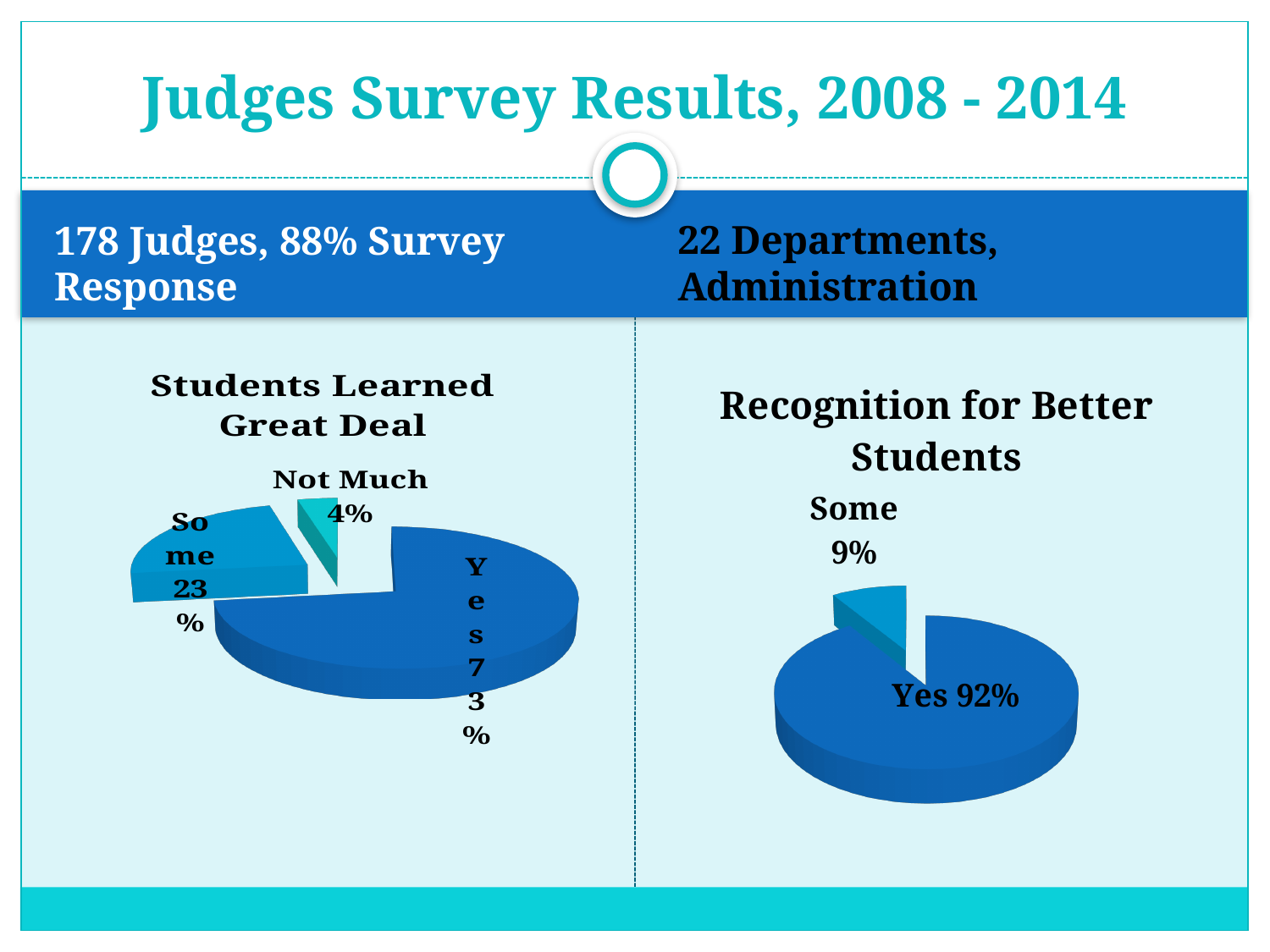
How many slices does the 'Students Learned Great Deal' chart have? 3 What type of chart is the 'Recognition for Better Students' chart? Pie chart In the 'Recognition for Better Students' chart, what percentage answered Yes? 92% In the 'Students Learned Great Deal' chart, what is the difference between the Yes and Some shares? 50% In the 'Students Learned Great Deal' chart, which response has the smallest share? Not Much In the 'Recognition for Better Students' chart, which response has the smaller share? Some In the 'Students Learned Great Deal' chart, what percentage answered Yes? 73% In the 'Students Learned Great Deal' chart, what percentage answered Not Much? 4% In the 'Recognition for Better Students' chart, what is the difference between the Yes and Some shares? 83% In the 'Students Learned Great Deal' chart, which response has the largest share? Yes In the 'Students Learned Great Deal' chart, what percentage answered Some? 23% In the 'Recognition for Better Students' chart, what percentage answered Some? 9%